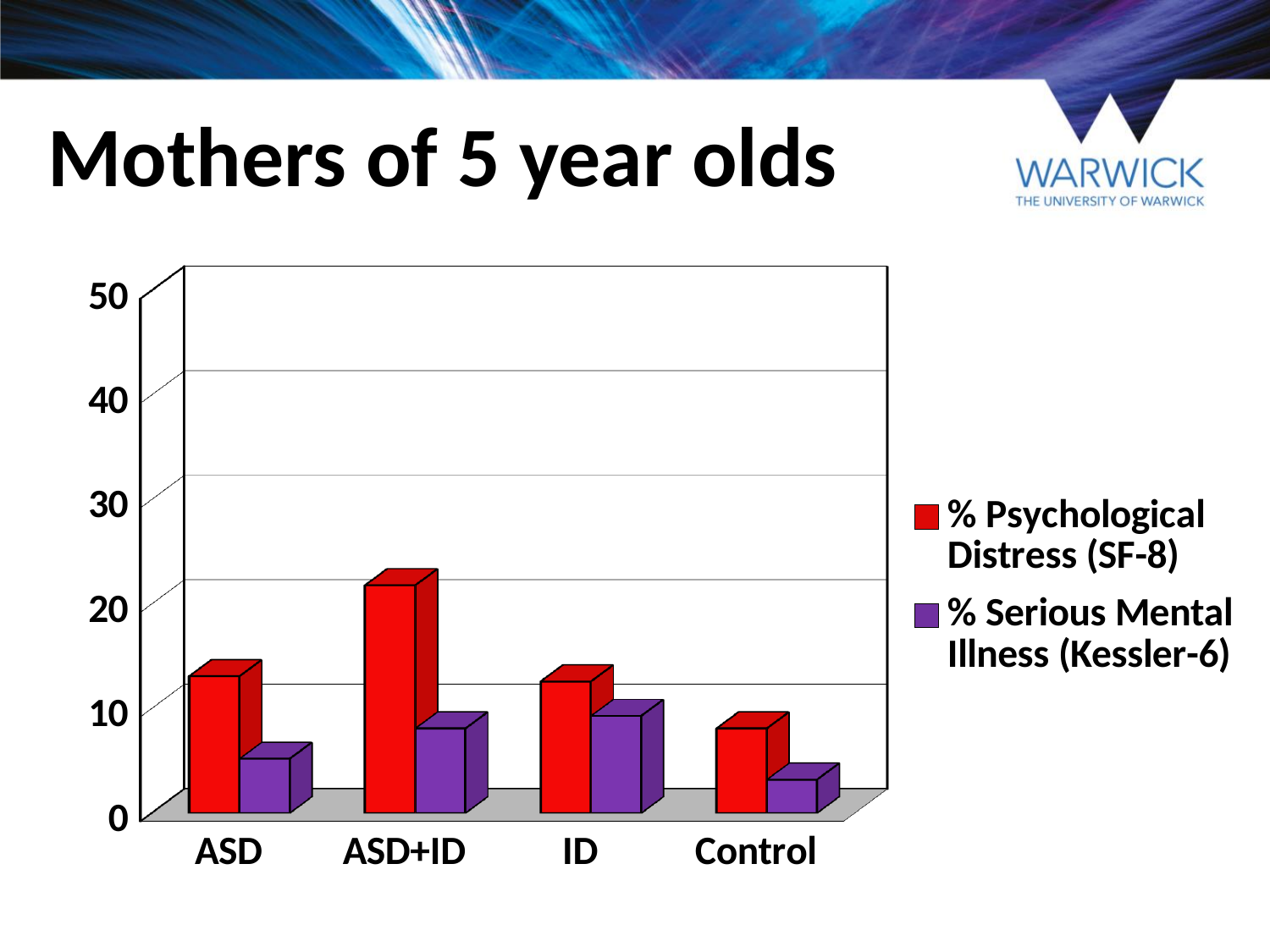
How many series does the chart's legend list? 2 Which category has the lowest value for % Psychological Distress (SF-8)? Control Which is larger for the ASD+ID group: % Psychological Distress (SF-8) or % Serious Mental Illness (Kessler-6)? % Psychological Distress (SF-8) Which colour represents % Serious Mental Illness (Kessler-6) in the chart? purple Is the value for % Serious Mental Illness (Kessler-6) in the ASD group greater or less than 10? less What kind of chart is shown on the slide? bar chart Is the value for % Psychological Distress (SF-8) in the Control group greater or less than 10? less Which category has the highest value for % Psychological Distress (SF-8)? ASD+ID Is the value for % Psychological Distress (SF-8) in the ASD group greater or less than 10? greater Which category has the lowest value for % Serious Mental Illness (Kessler-6)? Control How many categories are shown on the x axis of the chart? 4